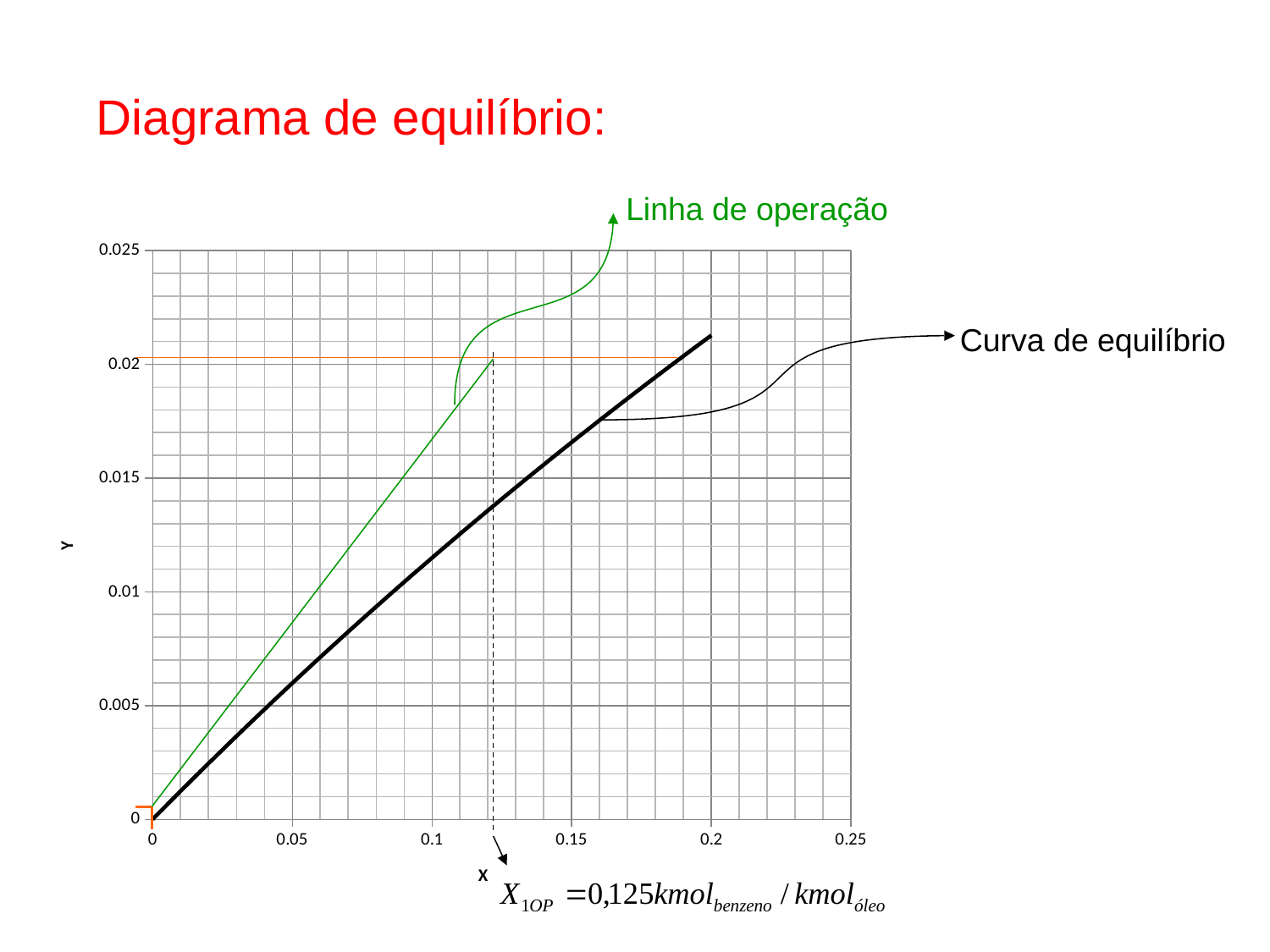
Is the Y value of the Curva de equilíbrio at X = 0.2 greater or less than 0.02? greater Do the values of the Curva de equilíbrio rise or fall as X increases? Rise What value of X_1OP is stated below the chart? 0,125 kmol benzeno / kmol óleo What label is given to the green line on the chart? Linha de operação What is the title of the slide containing the chart? Diagrama de equilíbrio: How many lines (curves) are plotted on the chart? 2 What is the maximum value shown on the Y axis of the chart? 0.025 At X = 0.1, which line has the higher Y value, the Linha de operação or the Curva de equilíbrio? Linha de operação Is the Y value of the Linha de operação at X = 0.1 greater or less than 0.015? greater What kind of chart is shown on the slide? Line chart Do the values of the Linha de operação rise or fall as X increases? Rise Is the Y value of the Curva de equilíbrio at X = 0.1 greater or less than 0.01? greater